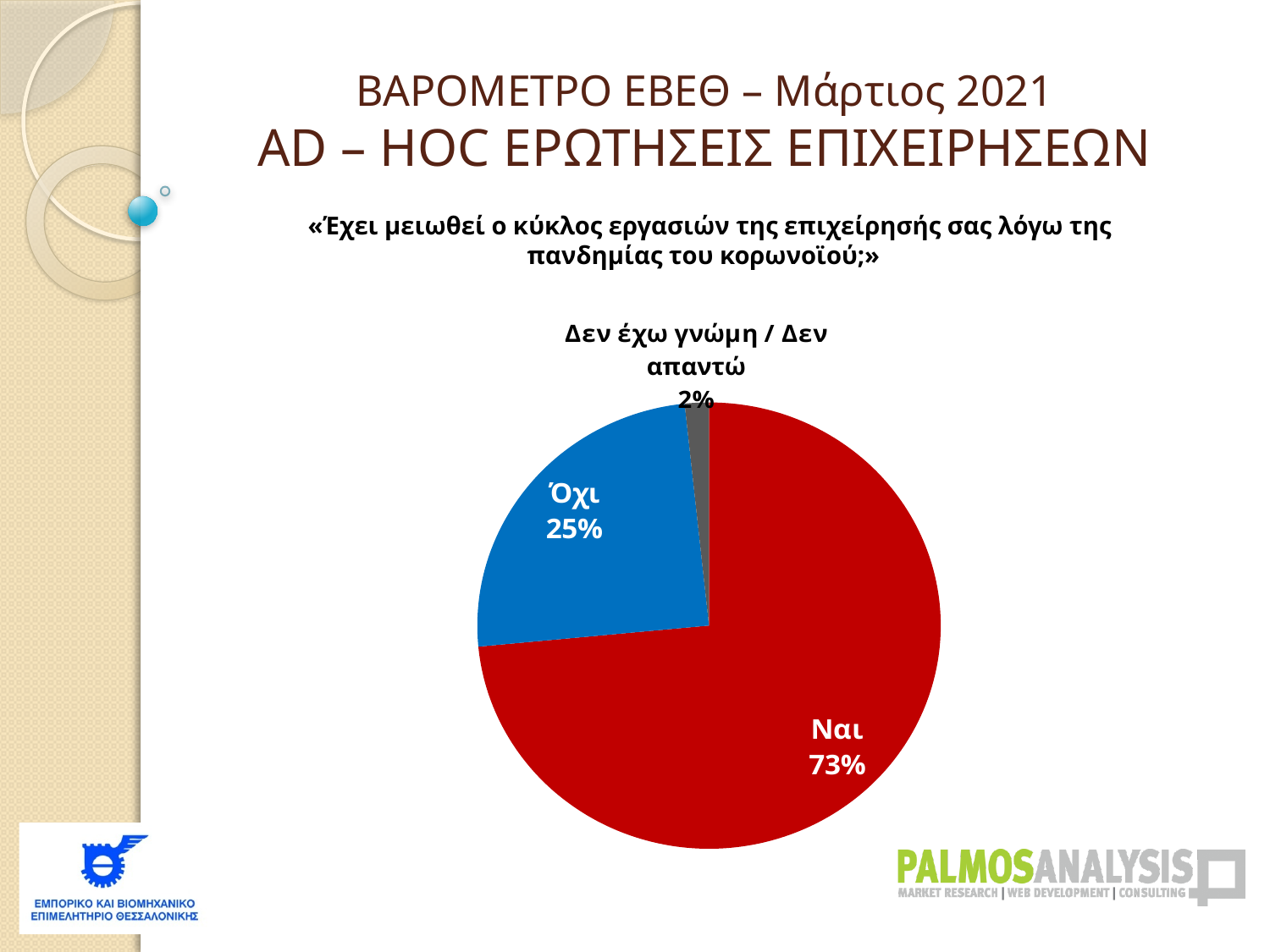
How many slices does the pie chart have? 3 Which is larger, the "Όχι" slice or the "Δεν έχω γνώμη / Δεν απαντώ" slice? Όχι What colour is the "Ναι" slice? Red Which category has the largest slice of the pie? Ναι What share of the pie does the "Όχι" slice represent? 25% Which category has the smallest slice of the pie? Δεν έχω γνώμη / Δεν απαντώ What share of the pie does the "Δεν έχω γνώμη / Δεν απαντώ" slice represent? 2% What is the difference in percentage points between the "Ναι" and "Όχι" slices? 48 What share of the pie does the "Ναι" slice represent? 73% What kind of chart is shown on the slide? Pie chart Is the "Ναι" slice greater or less than 50% of the pie? greater What colour is the "Όχι" slice? Blue